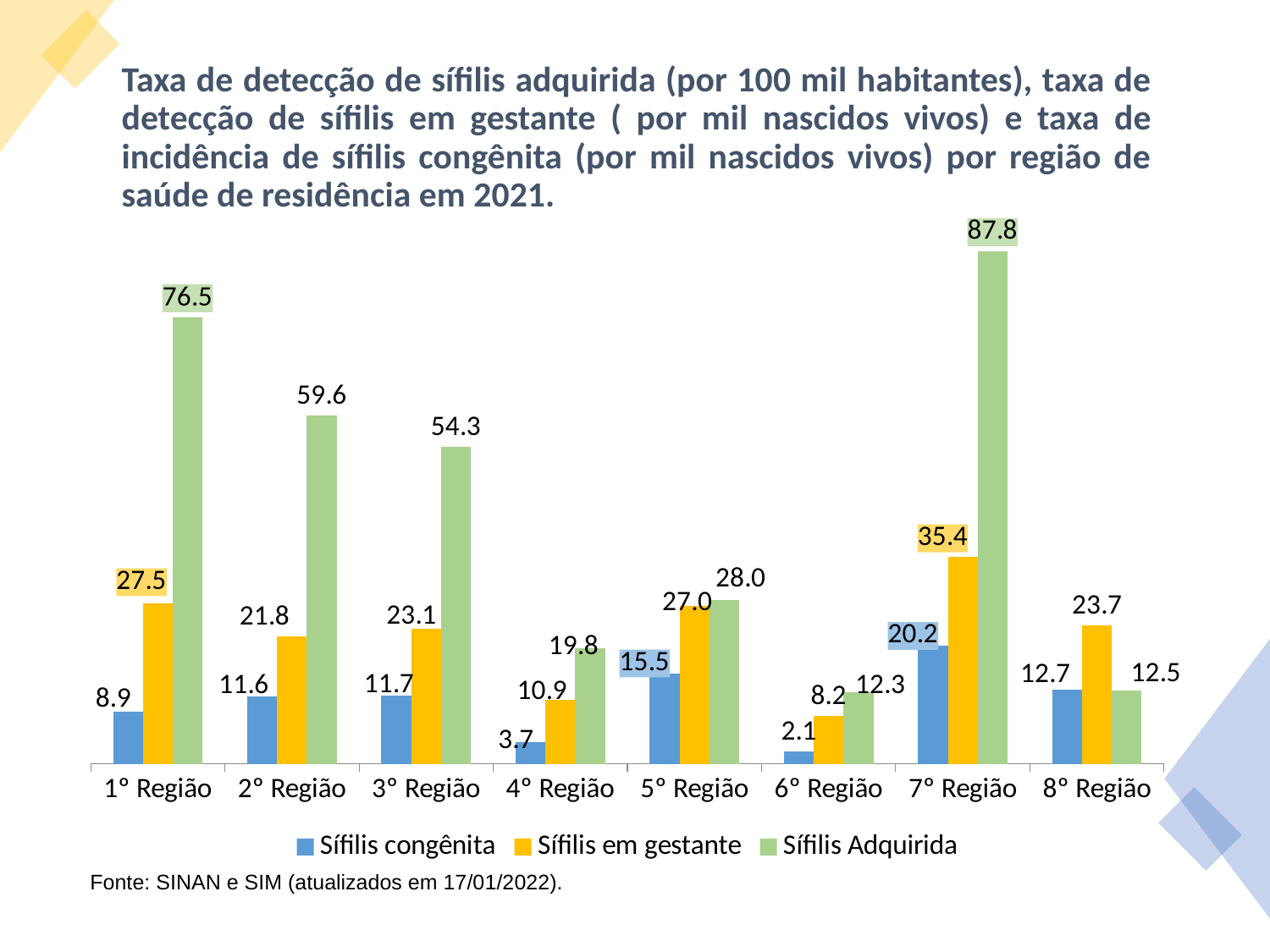
Which region has the highest value for Sífilis em gestante? 7° Região How many series does the legend list? 3 What is the value of Sífilis congênita for 4° Região? 3.7 How many regions are shown on the x axis? 8 Which is larger for 8° Região: Sífilis em gestante or Sífilis Adquirida? Sífilis em gestante What is the value of Sífilis em gestante for 1° Região? 27.5 Which region has the highest value for Sífilis Adquirida? 7° Região Which region has the lowest value for Sífilis congênita? 6° Região What is the value of Sífilis Adquirida for 7° Região? 87.8 What is the source cited below the chart? SINAN e SIM (atualizados em 17/01/2022) What is the difference between the Sífilis Adquirida values for 1° Região and 2° Região? 16.9 What kind of chart is shown on the slide? Bar chart